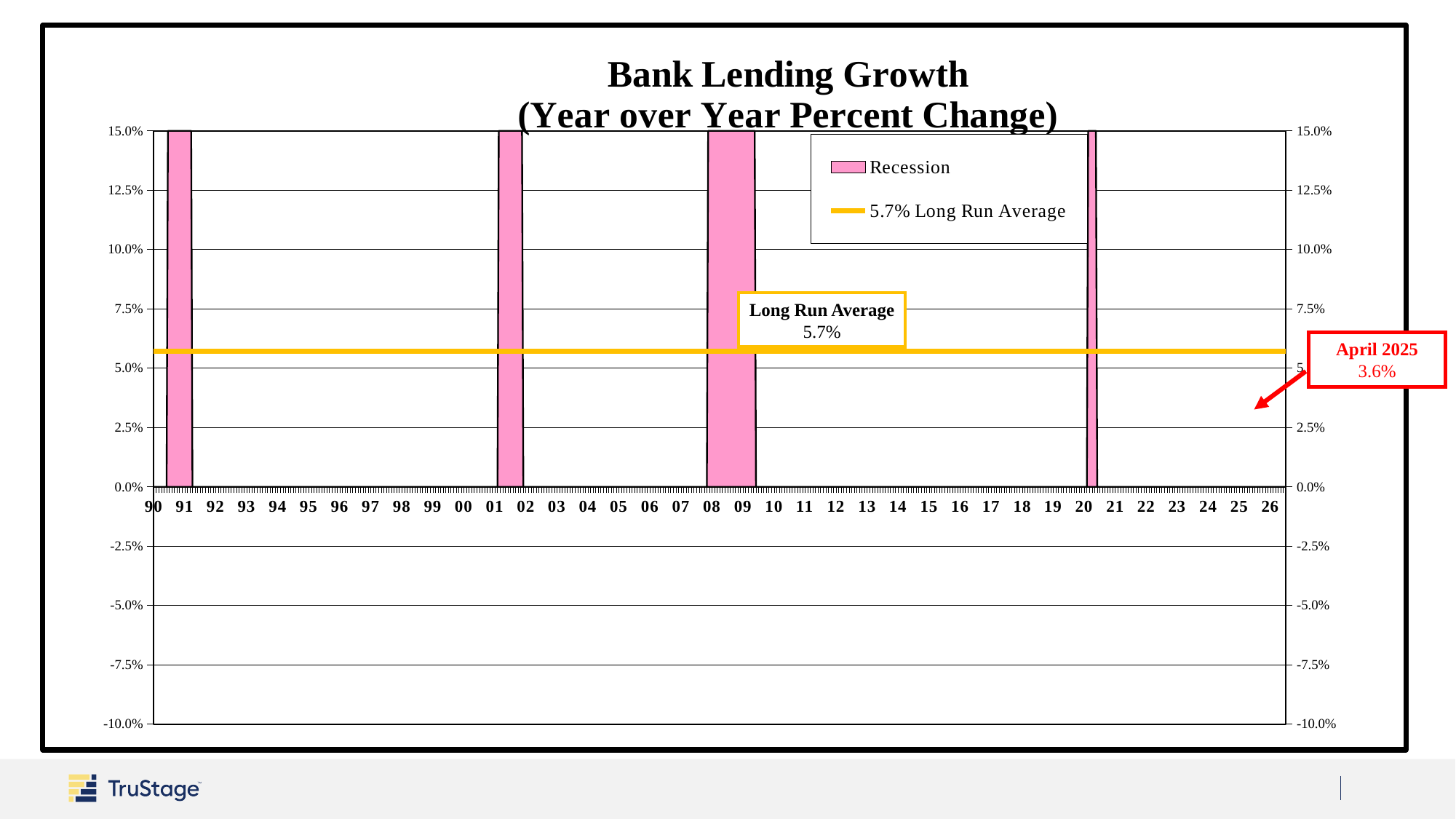
What value does the chart annotation give for April 2025? 3.6% Is the April 2025 value greater or less than 5.0%? less Which is larger: the April 2025 value or the long run average? Long run average What is the lowest value shown on the vertical axis? -10.0% What is the title of the chart? Bank Lending Growth (Year over Year Percent Change) By how many percentage points is the April 2025 value below the 5.7% long run average? 2.1 percentage points How many shaded recession periods are shown on the chart? 4 What colour are the recession bars on the chart? Pink How many entries does the chart's legend list? 2 Is the long run average line greater or less than 5.0%? greater What is the highest value shown on the vertical axis? 15.0% What is the long run average value shown on the chart? 5.7%